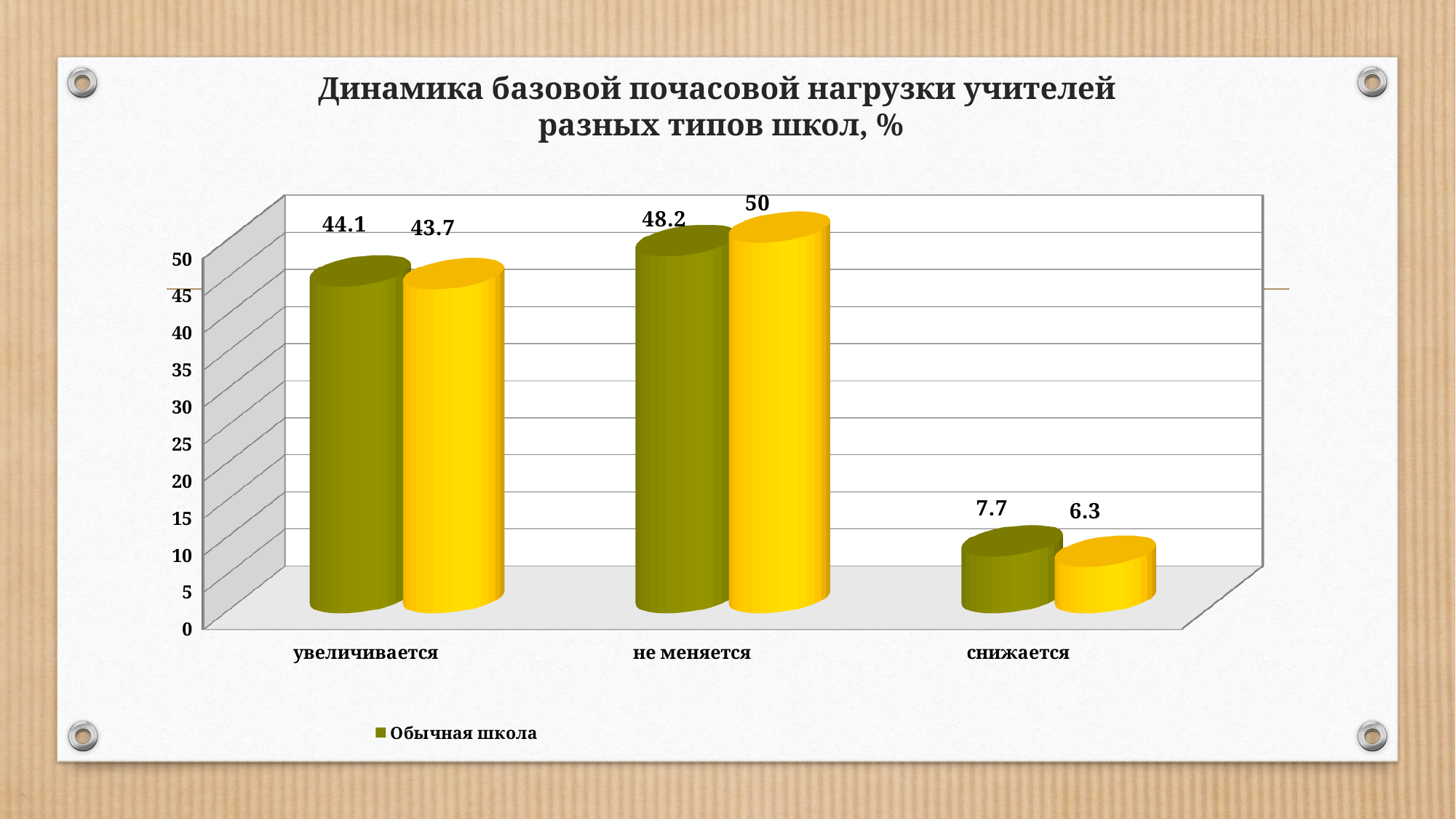
What is the value of the yellow bar in the не меняется category? 50 What is the value for Обычная школа in the увеличивается category? 44.1 What is the value for Обычная школа in the снижается category? 7.7 For the Обычная школа series, which category has the highest value? не меняется In the снижается category, which is larger: the Обычная школа bar or the yellow bar? Обычная школа In the увеличивается category, what is the difference between the Обычная школа value and the yellow bar value? 0.4 What type of chart is shown on the slide? Bar chart What is the value of the yellow bar in the снижается category? 6.3 What is the value for Обычная школа in the не меняется category? 48.2 How many categories are shown on the x axis? 3 For the yellow series, which category has the lowest value? снижается In the не меняется category, how much larger is the yellow bar than the Обычная школа bar? 1.8